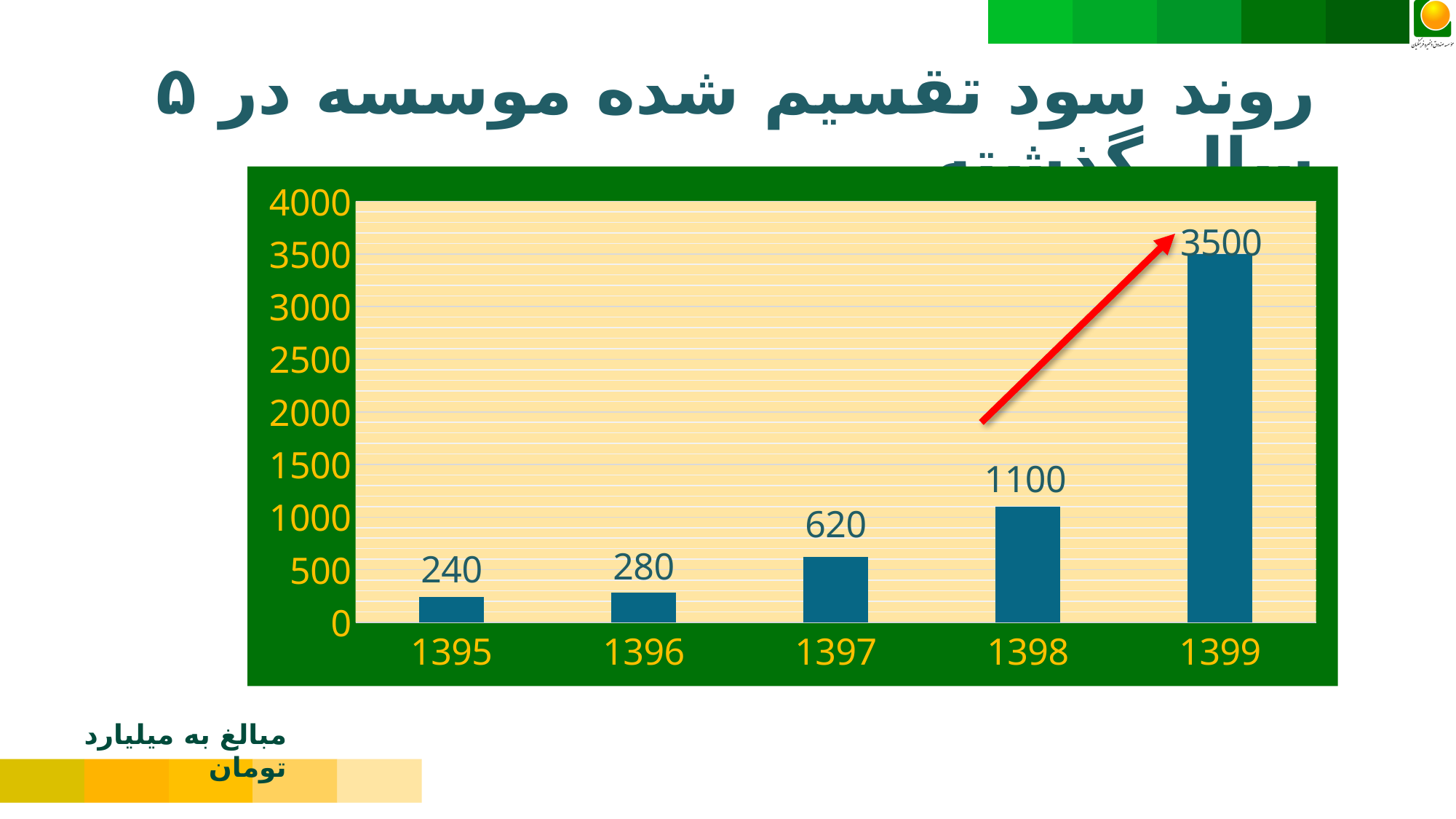
What is the value for 1399? 3500 How many years are shown on the x axis? 5 Is the value for 1398 greater or less than 1000? greater What is the difference between the values for 1399 and 1398? 2400 What is the difference between the values for 1396 and 1395? 40 Which year has the lowest value? 1395 What kind of chart is shown on the slide? bar chart Do the values rise or fall from 1395 to 1399? rise Which year has the highest value? 1399 What is the value for 1395? 240 Which is larger, the value for 1397 or the value for 1398? 1398 What is the value for 1397? 620